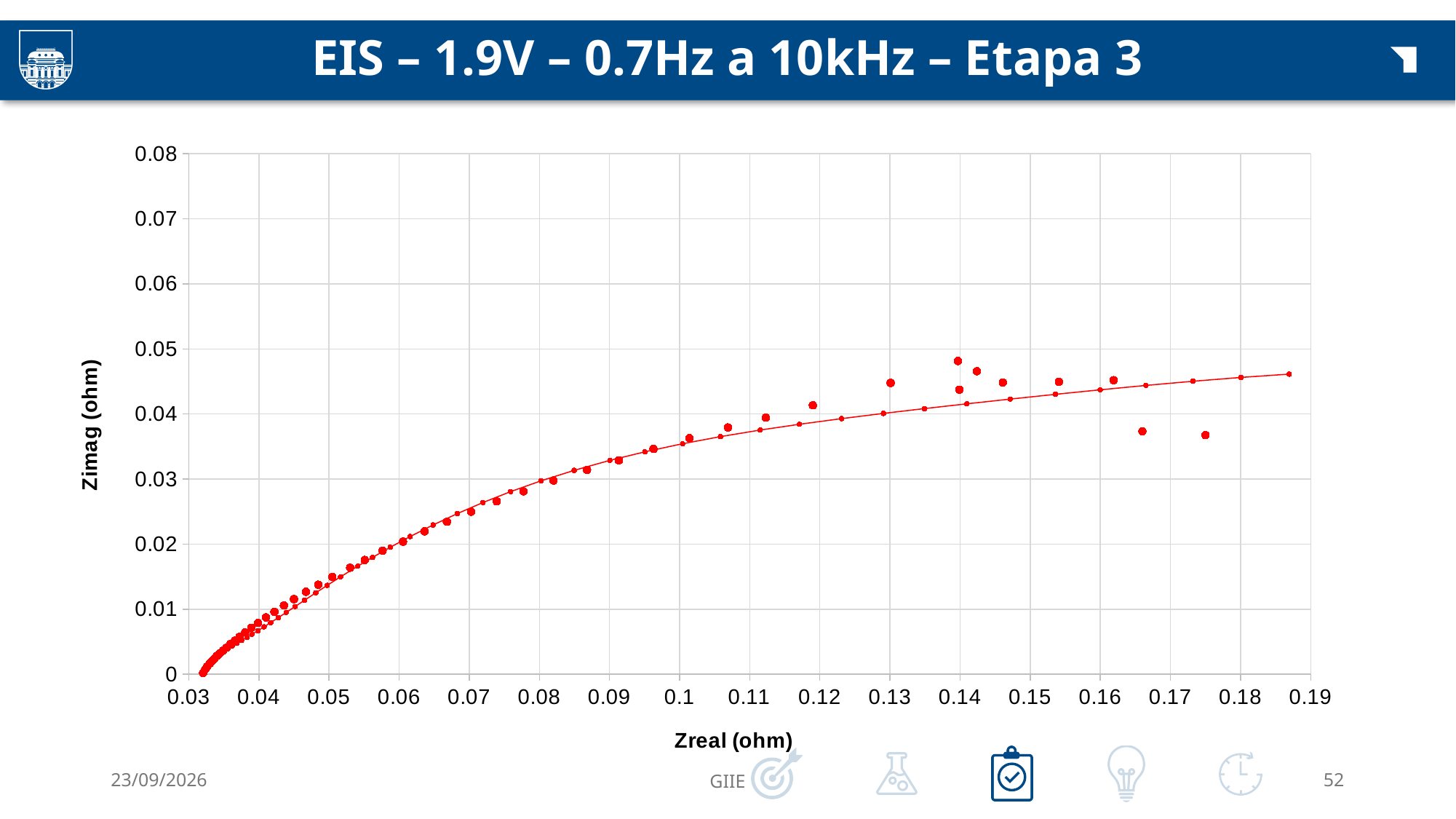
Is the highest Zimag value plotted greater or less than 0.05? less Is the Zimag value of the point at Zreal 0.05 greater or less than 0.02? less What kind of chart is shown on the slide? scatter chart Is the Zimag value of the point at Zreal 0.1 greater or less than 0.03? greater What is the title of the chart? EIS – 1.9V – 0.7Hz a 10kHz – Etapa 3 Do the Zimag values generally rise or fall as Zreal increases along the x axis? rise What is the label of the horizontal axis? Zreal (ohm) Which has the larger Zimag value: the point at Zreal 0.06 or the point at Zreal 0.12? the point at Zreal 0.12